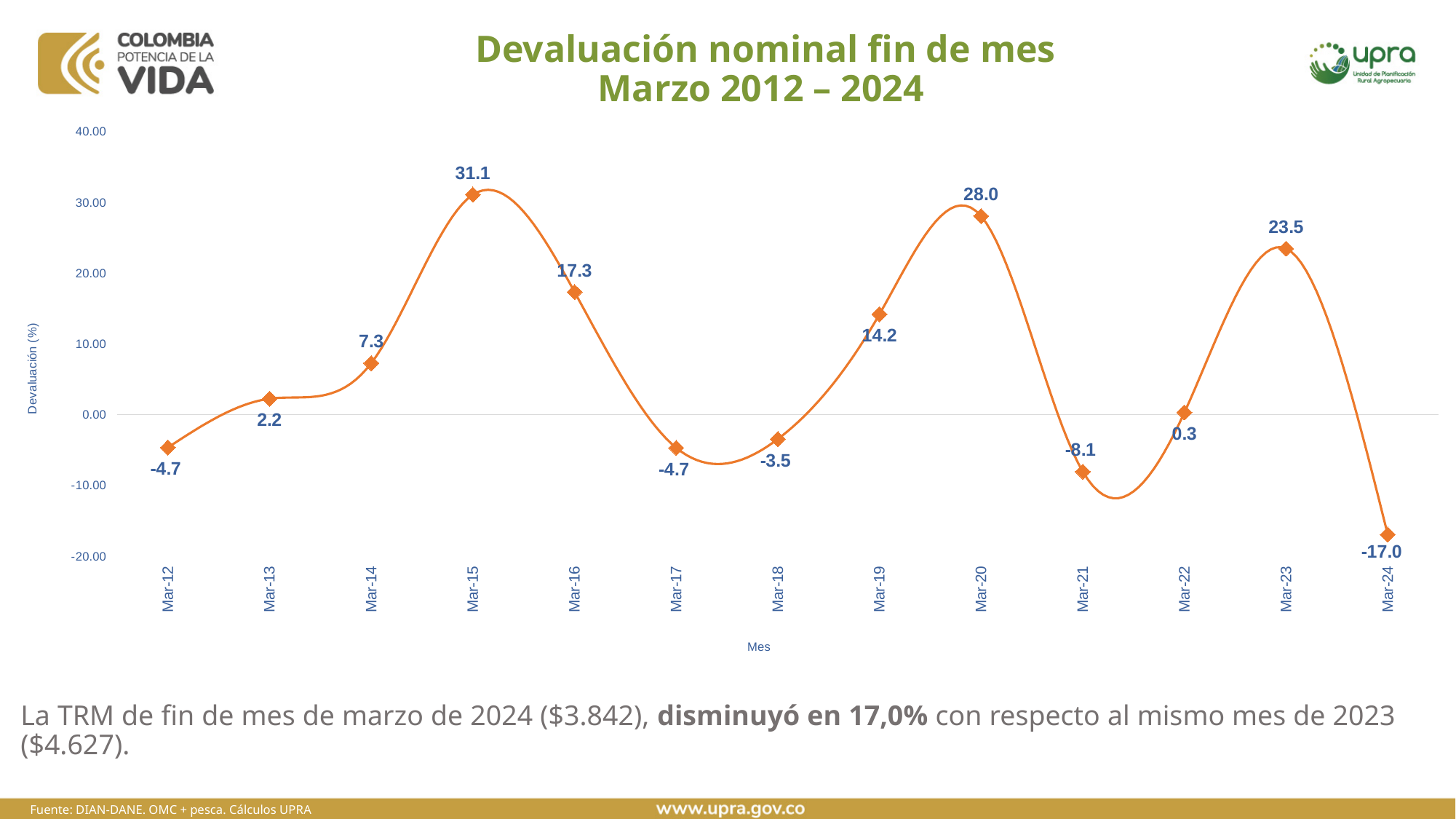
What is the value for Mar-15? 31.1 Which month has the highest value? Mar-15 Is the value for Mar-20 greater or less than 20.00? greater Which month has the lowest value? Mar-24 What is the title of the chart? Devaluación nominal fin de mes Marzo 2012 – 2024 How many data points are plotted on the chart? 13 What is the value for Mar-24? -17.0 Do the values rise or fall from Mar-23 to Mar-24? fall What is the value for Mar-21? -8.1 Which is larger, the value for Mar-16 or the value for Mar-19? Mar-16 What kind of chart is shown? line chart What is the difference between the values for Mar-20 and Mar-23? 4.5